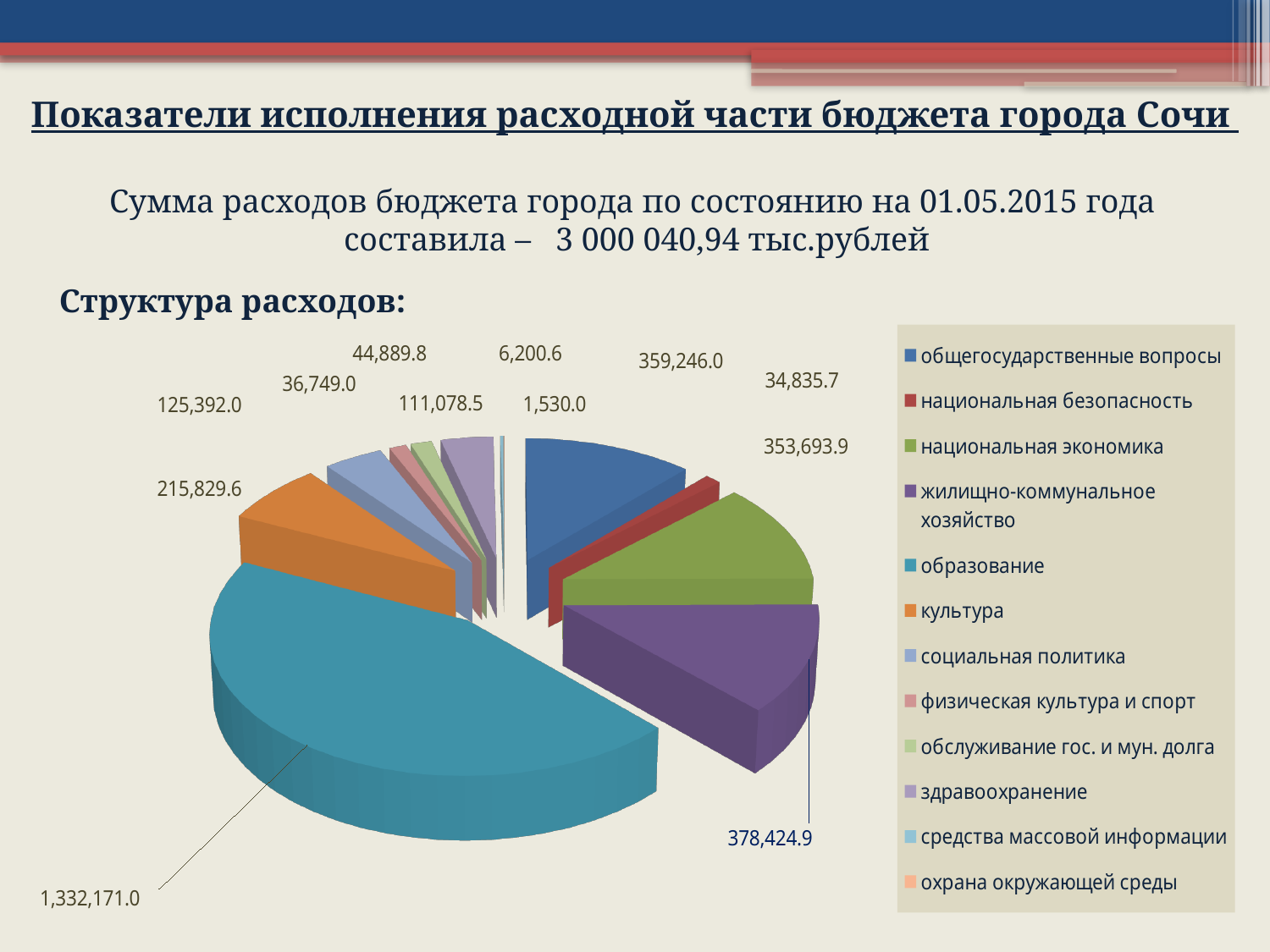
What is the value for культура in the pie chart? 215,829.6 What is the value for жилищно-коммунальное хозяйство in the pie chart? 378,424.9 What heading is printed directly above the pie chart? Структура расходов: What is the value for образование in the pie chart? 1,332,171.0 Which is larger in the pie chart: жилищно-коммунальное хозяйство or общегосударственные вопросы? жилищно-коммунальное хозяйство How many categories does the legend of the pie chart list? 12 What is the value for национальная безопасность in the pie chart? 34,835.7 What is the difference between the values for общегосударственные вопросы and национальная безопасность in the pie chart? 324,410.3 Which category has the largest slice in the pie chart? образование Which is larger in the pie chart: образование or культура? образование What kind of chart is shown on the slide? Pie chart Which category has the smallest value in the pie chart? охрана окружающей среды